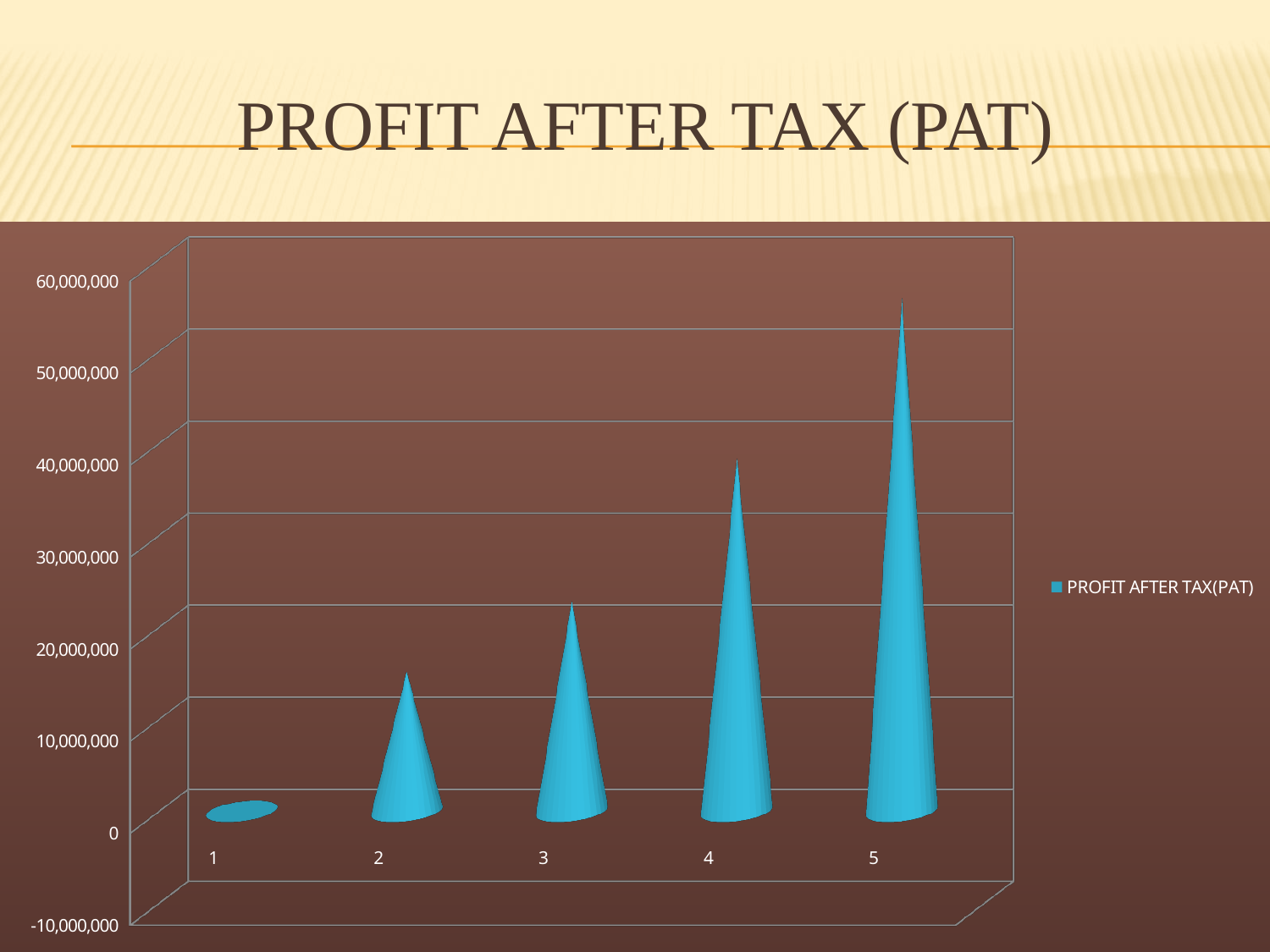
Is the value for category 2 greater or less than 20,000,000? less Which is larger, the value for category 4 or the value for category 5? 5 How many categories are plotted on the x axis? 5 What series name is shown in the legend? PROFIT AFTER TAX(PAT) What kind of chart is shown on the slide? bar chart Is the value for category 3 greater or less than 30,000,000? less Is the value for category 5 greater or less than 50,000,000? greater How many series does the legend list? 1 Do the values rise or fall from category 1 to category 5? rise Which category has the lowest profit after tax? 1 Which category has the highest profit after tax? 5